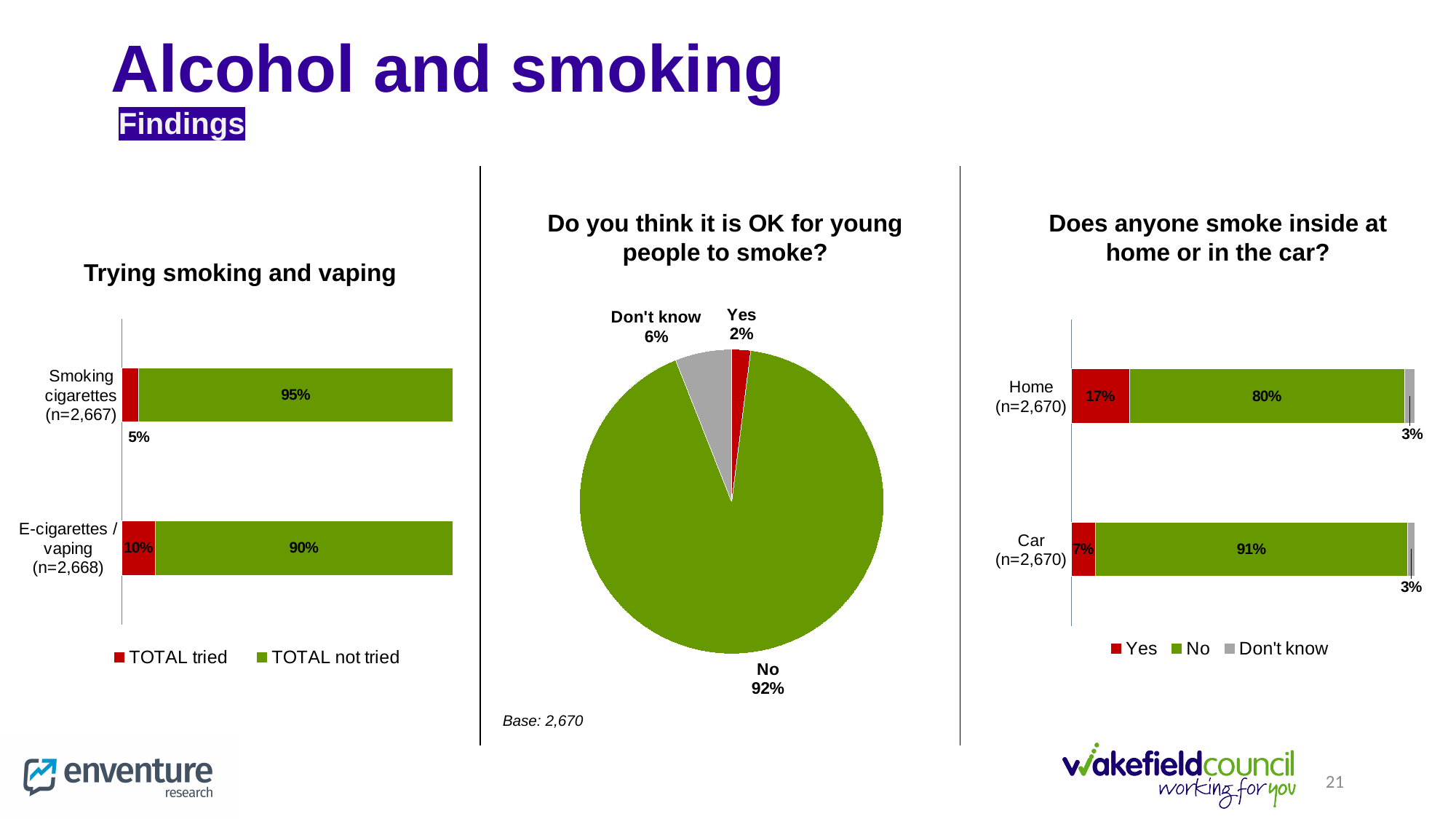
What kind of chart is 'Does anyone smoke inside at home or in the car?'? Stacked bar chart In the 'Do you think it is OK for young people to smoke?' chart, which slice is the smallest? Yes In the 'Trying smoking and vaping' chart, what percentage of respondents have tried smoking cigarettes? 5% What kind of chart is 'Do you think it is OK for young people to smoke?'? Pie chart In the 'Trying smoking and vaping' chart, what is the difference between the 'TOTAL not tried' values for smoking cigarettes and e-cigarettes / vaping? 5% In the 'Trying smoking and vaping' chart, which category has the higher 'TOTAL tried' value, smoking cigarettes or e-cigarettes / vaping? E-cigarettes / vaping In the 'Does anyone smoke inside at home or in the car?' chart, what is the 'Yes' value for Home? 17% In the 'Trying smoking and vaping' chart, what percentage of respondents have not tried e-cigarettes / vaping? 90% In the 'Do you think it is OK for young people to smoke?' chart, what share of the pie is 'Don't know'? 6% In the 'Does anyone smoke inside at home or in the car?' chart, what is the difference between the 'No' values for Car and Home? 11% In the 'Trying smoking and vaping' chart, how many series does the legend list? 2 In the 'Do you think it is OK for young people to smoke?' chart, what share of the pie is 'No'? 92%